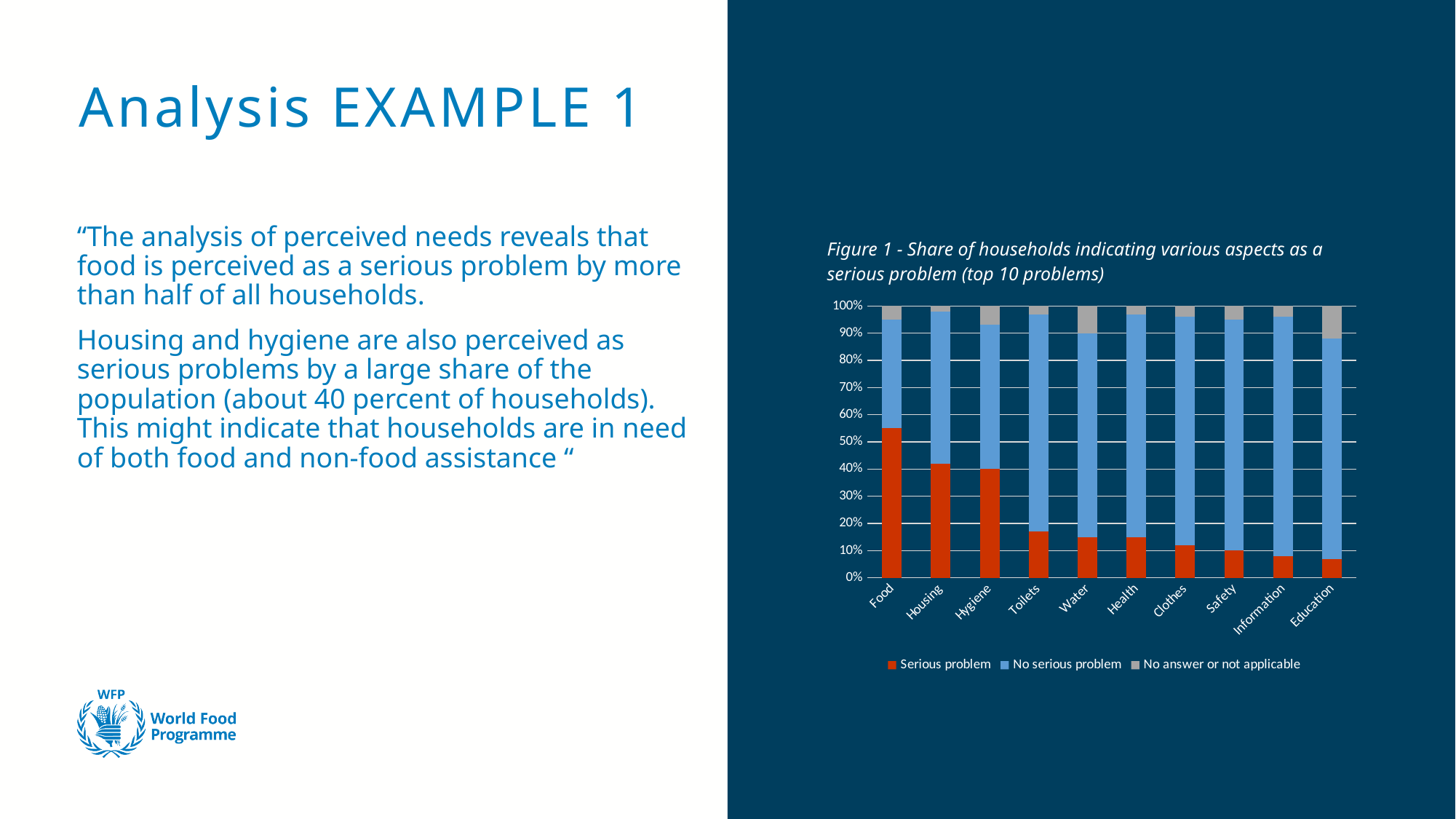
Which category has the highest share of households indicating a serious problem? Food Is the 'Serious problem' share for Toilets greater or less than 20%? less Is the 'Serious problem' share for Housing greater or less than 50%? less Is the 'Serious problem' share for Hygiene greater or less than 30%? greater How many series does the chart's legend list? 3 How many categories (problems) are shown on the x axis of the chart? 10 Does the 'Serious problem' share rise or fall moving from Food on the left to Education on the right? Fall Which series in the legend is shown in red? Serious problem What kind of chart is shown on the slide? Stacked bar chart Which has a larger 'Serious problem' share, Food or Housing? Food